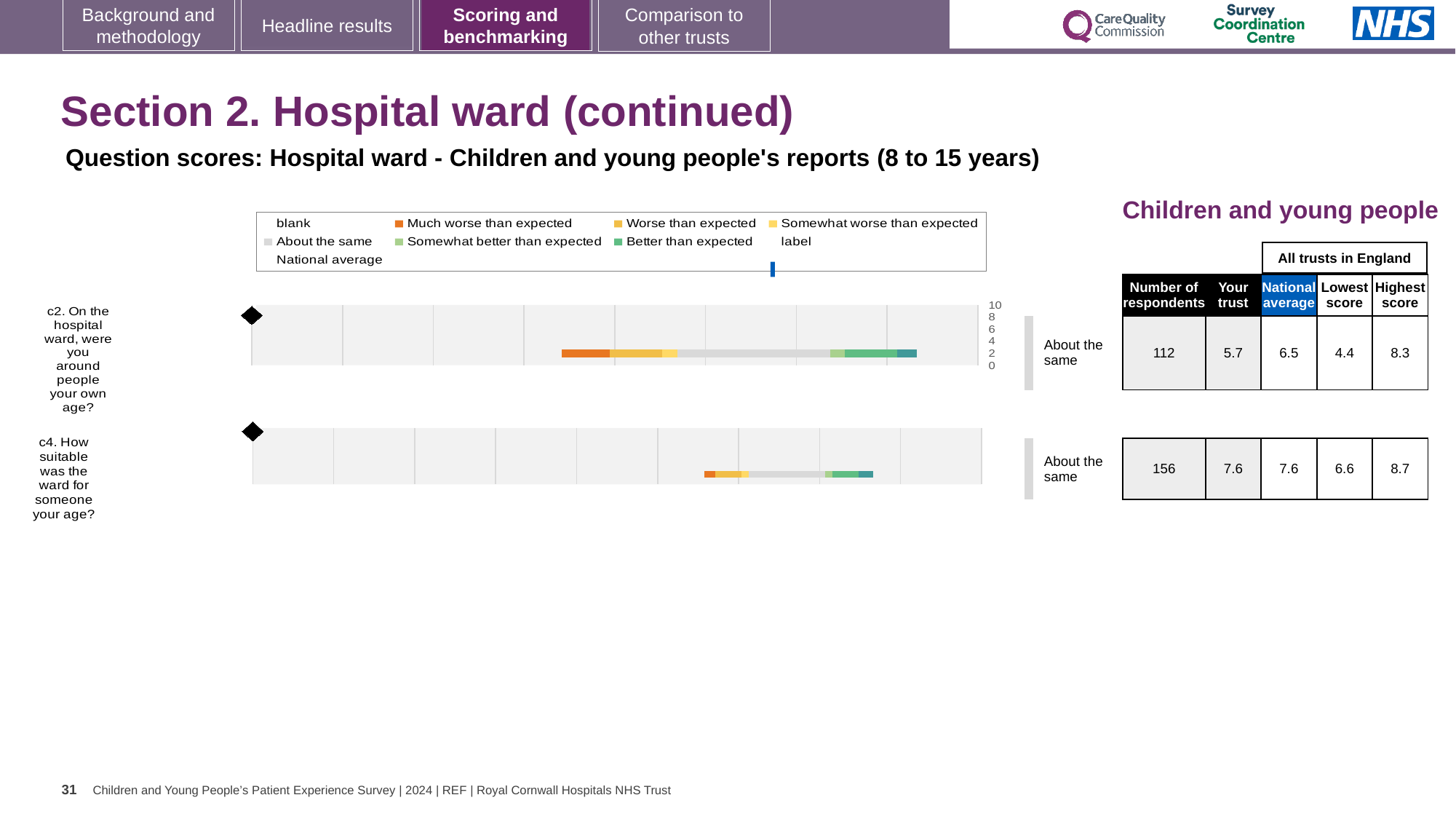
What is the 'Your trust' score for question c2 (On the hospital ward, were you around people your own age?)? 5.7 How many respondents answered question c4? 156 What is the highest score among all trusts in England for question c4? 8.7 Which colour represents 'Much worse than expected' in the legend? orange What is the difference between the highest and lowest scores for question c2? 3.9 What kind of chart is used to show the question scores on this slide? bar chart What benchmark category is shown for question c2? About the same How many questions are plotted on the chart? 2 What is the national average score for question c4 (How suitable was the ward for someone your age?)? 7.6 What is the lowest score among all trusts in England for question c2? 4.4 Which question has the higher 'Your trust' score, c2 or c4? c4 How much higher is the national average than the trust's score for question c2? 0.8